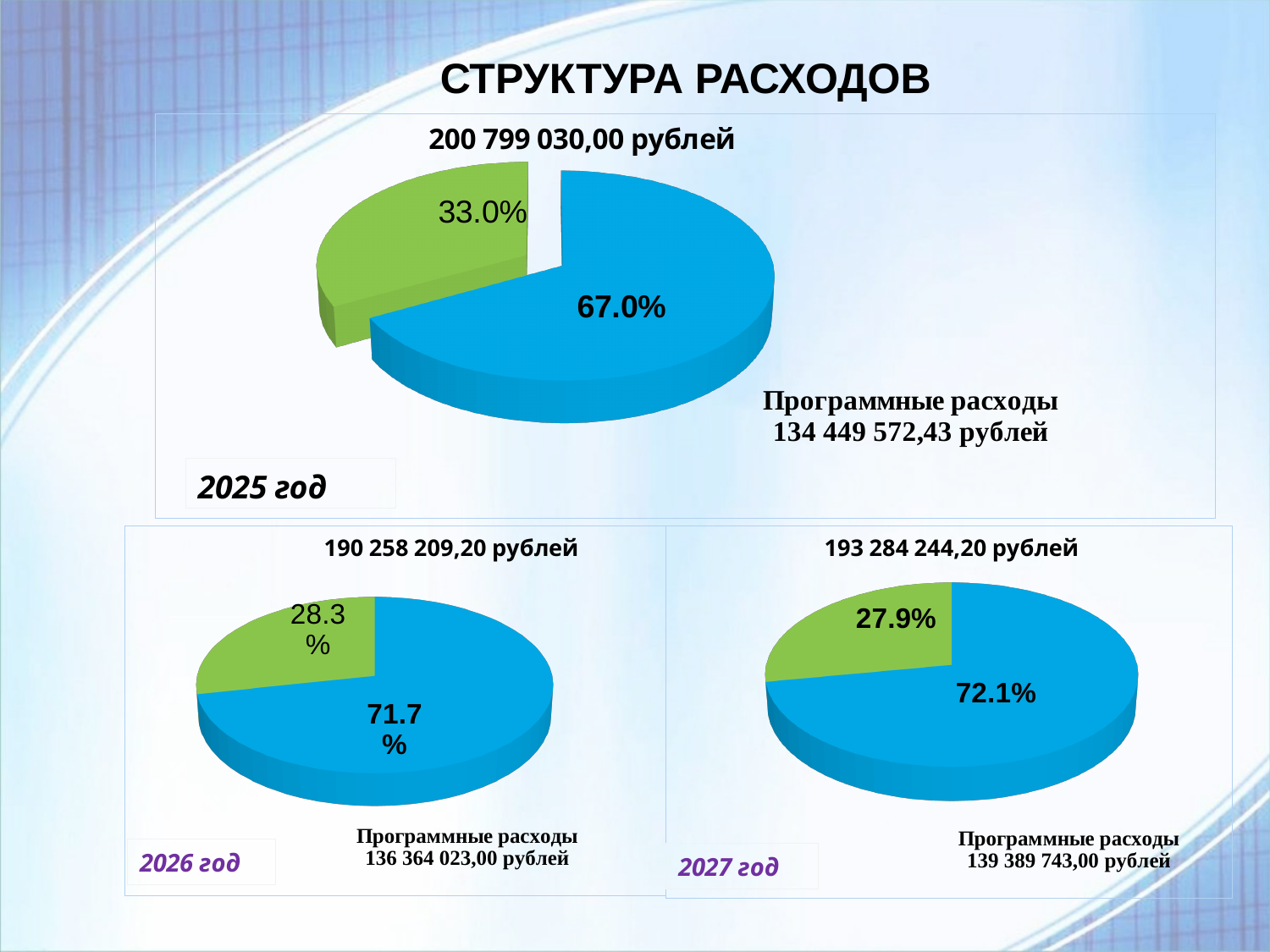
In the 2025 год pie chart, what share is shown for the blue slice (Программные расходы)? 67.0% In the 2026 год pie chart, what share is shown for the blue slice (Программные расходы)? 71.7% What kind of chart is used for the 2025 год expenditure structure? pie chart What is the value of Программные расходы shown for the 2026 год chart? 136 364 023,00 рублей In the 2025 год pie chart, what share is shown for the green slice? 33.0% What is the title of the slide containing the three pie charts? СТРУКТУРА РАСХОДОВ What total amount in rubles is shown above the 2027 год pie chart? 193 284 244,20 рублей In the 2026 год pie chart, which slice is larger, the blue one or the green one? the blue one What is the difference between the blue and green slice percentages in the 2027 год pie chart? 44.2% How many slices does the 2027 год pie chart have? 2 What total amount in rubles is shown above the 2025 год pie chart? 200 799 030,00 рублей